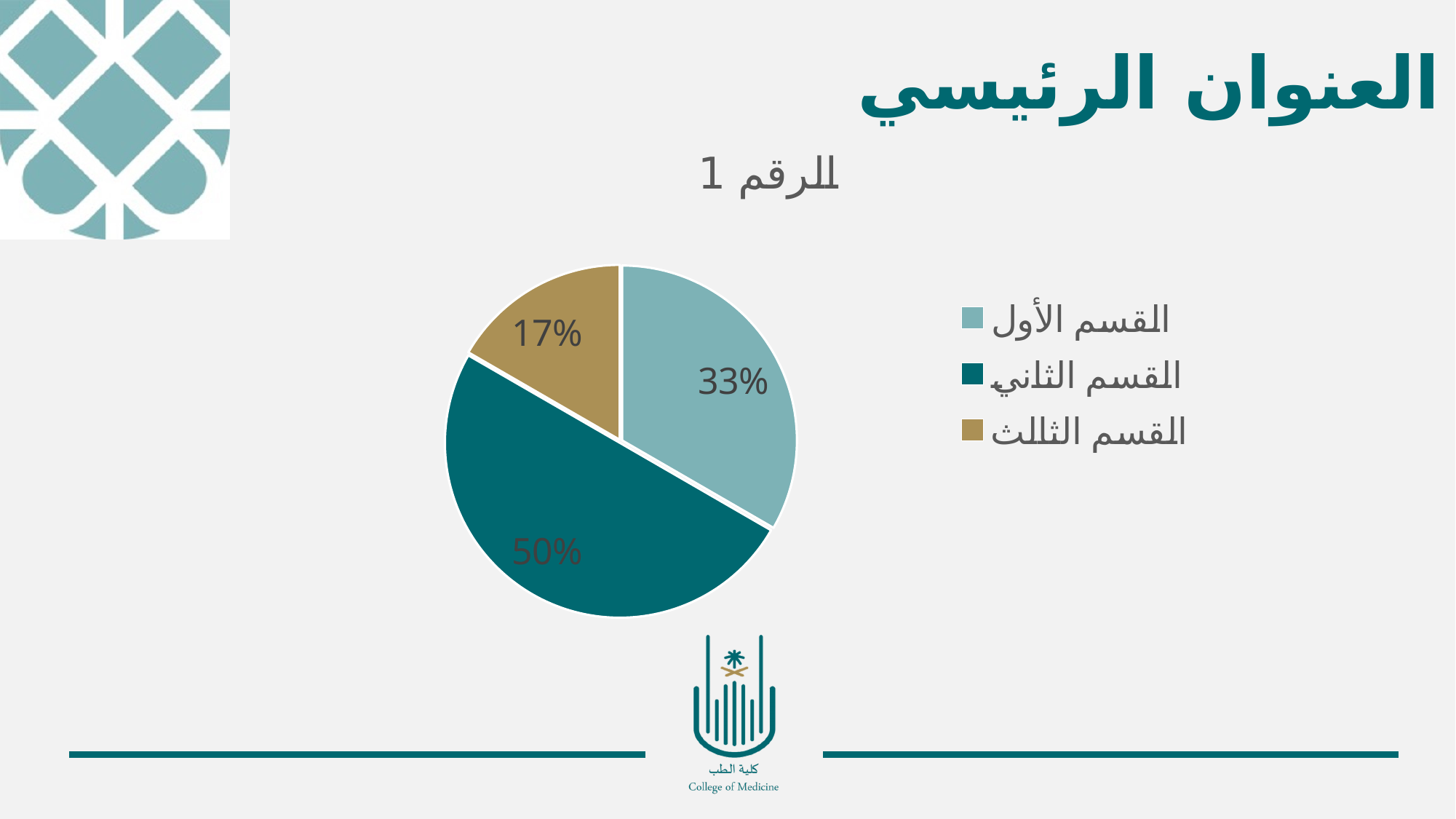
Which is larger, the slice for القسم الأول or the slice for القسم الثالث? القسم الأول Which category has the smallest slice of the pie? القسم الثالث What is the difference in percentage points between القسم الأول and القسم الثالث? 16 Which category has the largest slice of the pie? القسم الثاني What is the difference in percentage points between القسم الثاني and القسم الأول? 17 What colour is the slice for القسم الثالث? Gold/tan What share of the pie does القسم الثاني represent? 50% How many slices does the pie chart have? 3 What kind of chart is shown on the slide? Pie chart What share of the pie does القسم الثالث represent? 17% How many entries does the legend list? 3 What share of the pie does القسم الأول represent? 33%